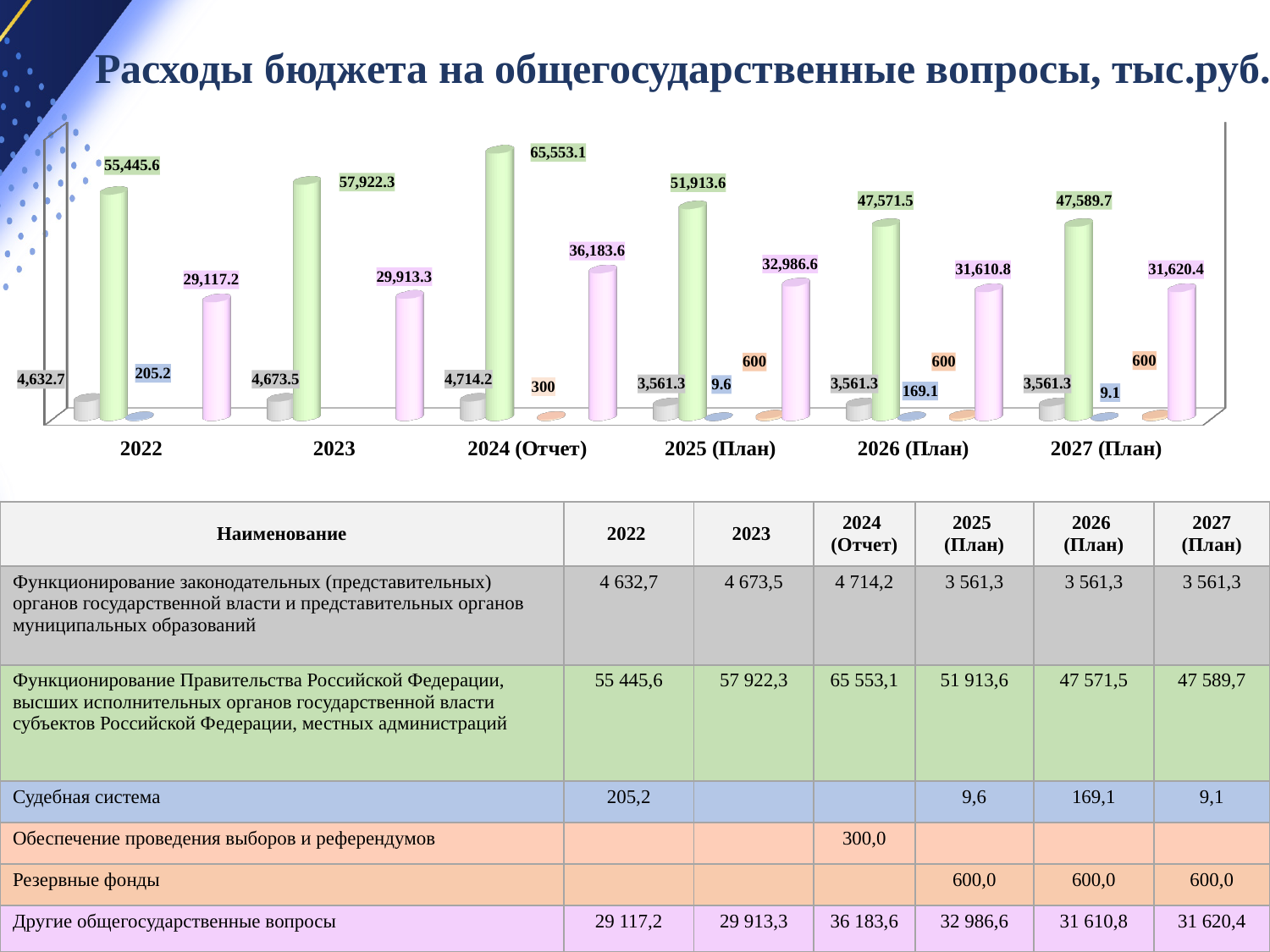
How many year categories are shown on the x axis of the chart? 6 What is the value of the green bar (Функционирование Правительства Российской Федерации) for 2022? 55,445.6 In which year does the green series (Функционирование Правительства Российской Федерации) reach its highest value? 2024 (Отчет) What is the difference between the green bar for 2024 (Отчет) and the green bar for 2025 (План)? 13,639.5 Does the pink series (Другие общегосударственные вопросы) rise or fall from 2022 to 2024 (Отчет)? Rise What kind of chart is shown on the slide? Bar chart What is the value of the tallest bar for 2024 (Отчет)? 65,553.1 What value is labelled for the orange bar (Обеспечение проведения выборов и референдумов) in 2024 (Отчет)? 300 In which year is the pink series (Другие общегосударственные вопросы) at its lowest? 2022 What is the difference between the grey bar for 2023 and the grey bar for 2022? 40.8 What is the value of the grey bar (Функционирование законодательных органов) for 2022? 4,632.7 Which is larger: the pink bar for 2025 (План) or the pink bar for 2026 (План)? 2025 (План)